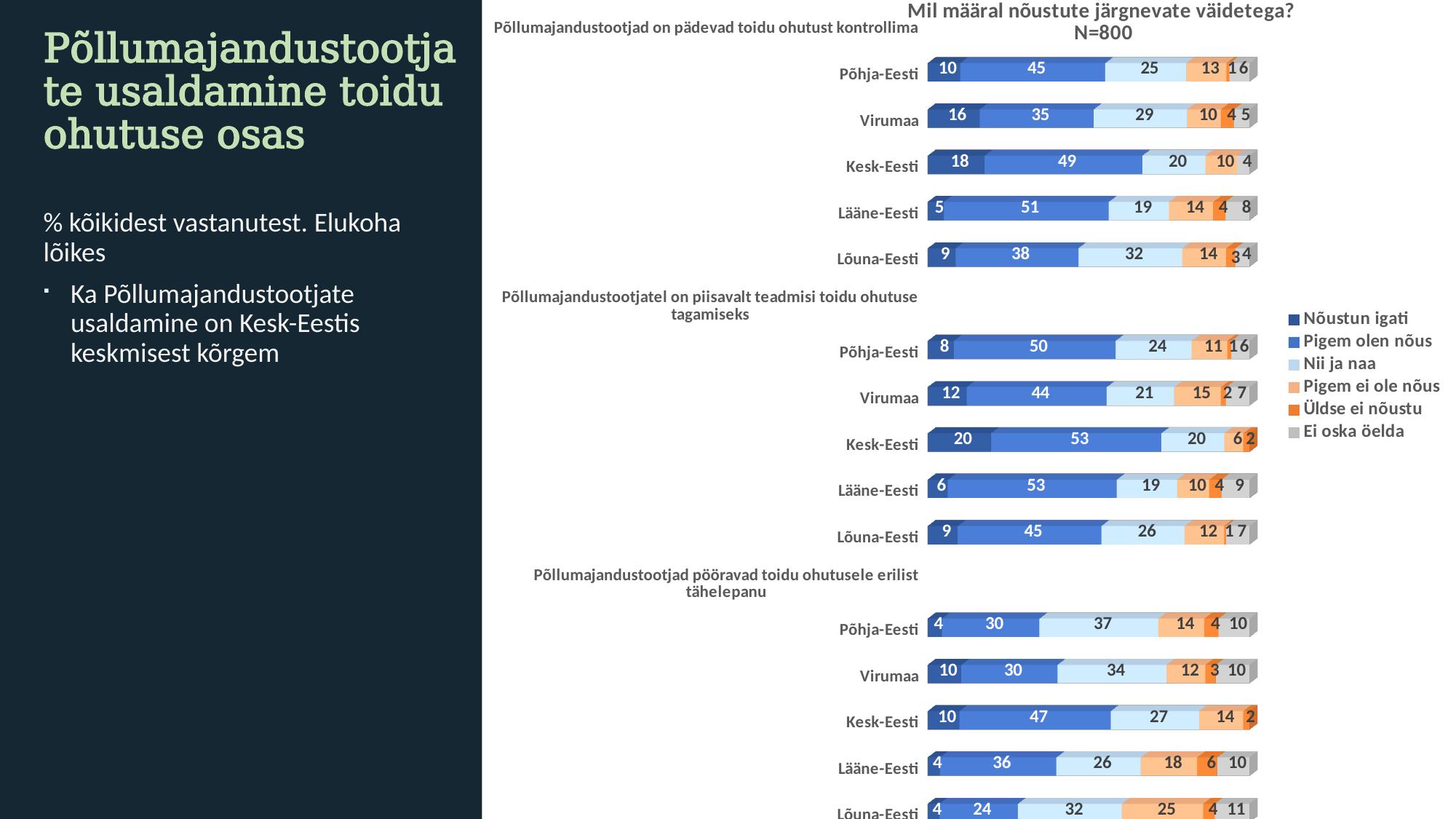
How many regions are shown for each statement in the chart? 5 Under the statement 'Põllumajandustootjad pööravad toidu ohutusele erilist tähelepanu', is the 'Nii ja naa' value larger for Põhja-Eesti or for Lääne-Eesti? Põhja-Eesti What is the 'Pigem ei ole nõus' value for Virumaa under the statement 'Põllumajandustootjatel on piisavalt teadmisi toidu ohutuse tagamiseks'? 15 What kind of chart is shown on the slide? bar chart How many series does the legend list? 6 Under the statement 'Põllumajandustootjatel on piisavalt teadmisi toidu ohutuse tagamiseks', which region has the highest 'Nõustun igati' value? Kesk-Eesti What is the 'Nõustun igati' value for Virumaa under the statement 'Põllumajandustootjad on pädevad toidu ohutust kontrollima'? 16 What is the 'Pigem olen nõus' value for Kesk-Eesti under the statement 'Põllumajandustootjad on pädevad toidu ohutust kontrollima'? 49 Under the statement 'Põllumajandustootjad pööravad toidu ohutusele erilist tähelepanu', which region has the lowest 'Pigem olen nõus' value? Lõuna-Eesti What is the difference between the 'Pigem olen nõus' values for Kesk-Eesti and Põhja-Eesti under the statement 'Põllumajandustootjad pööravad toidu ohutusele erilist tähelepanu'? 17 What is the 'Nii ja naa' value for Lõuna-Eesti under the statement 'Põllumajandustootjad on pädevad toidu ohutust kontrollima'? 32 What sample size (N) is stated in the chart title? N=800